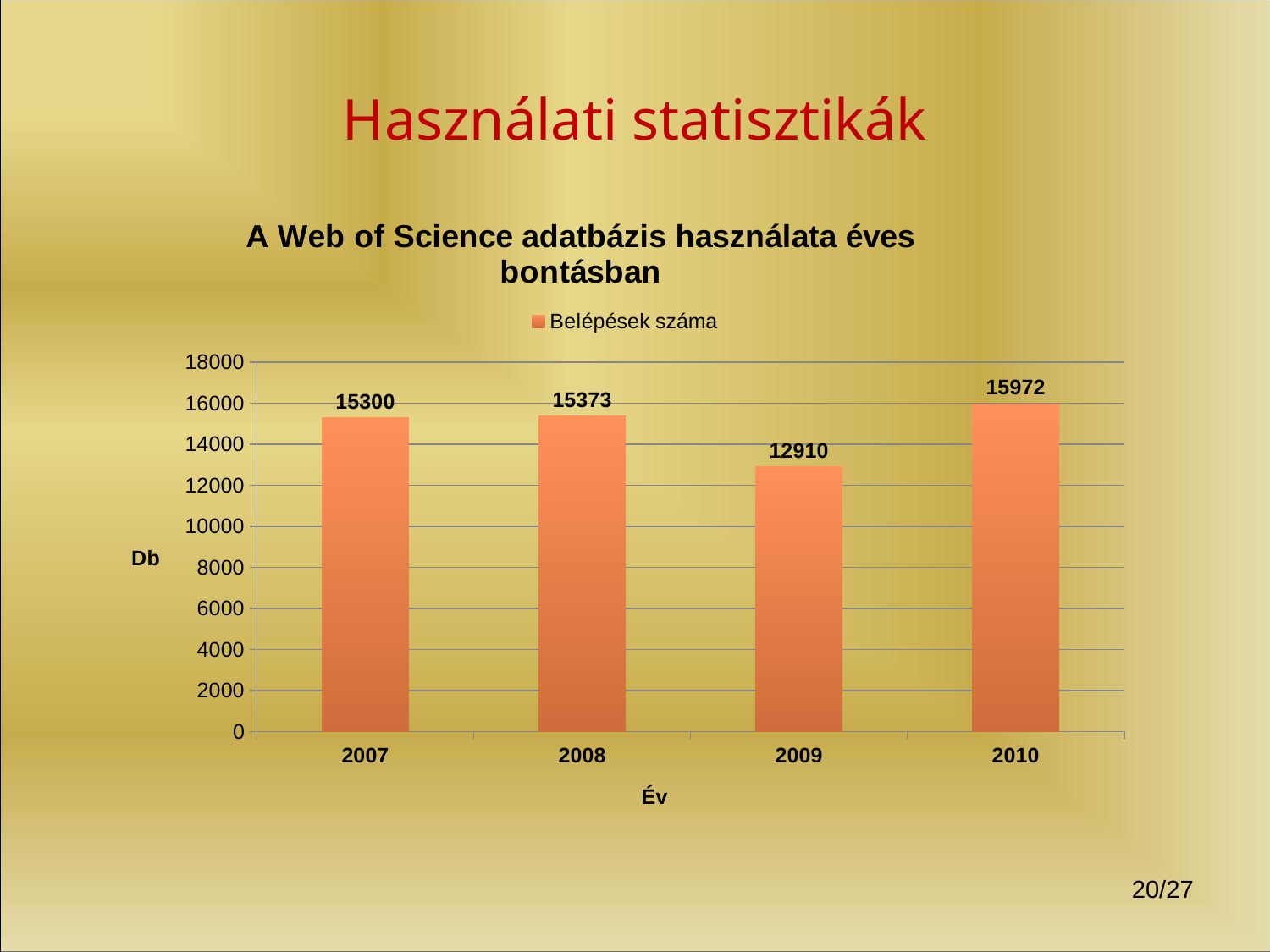
Is the value for 2009 greater or less than 14000? less What is the number of logins (Belépések száma) for 2007? 15300 What kind of chart is shown on the slide? bar chart What is the difference between the number of logins in 2010 and 2009? 3062 Which year has the lowest number of logins? 2009 What is the number of logins (Belépések száma) for 2009? 12910 How many years are shown on the x axis? 4 What is the number of logins (Belépések száma) for 2010? 15972 What is the difference between the number of logins in 2008 and 2007? 73 Which year has more logins, 2008 or 2009? 2008 Which year has the highest number of logins? 2010 What is the title of the chart? A Web of Science adatbázis használata éves bontásban